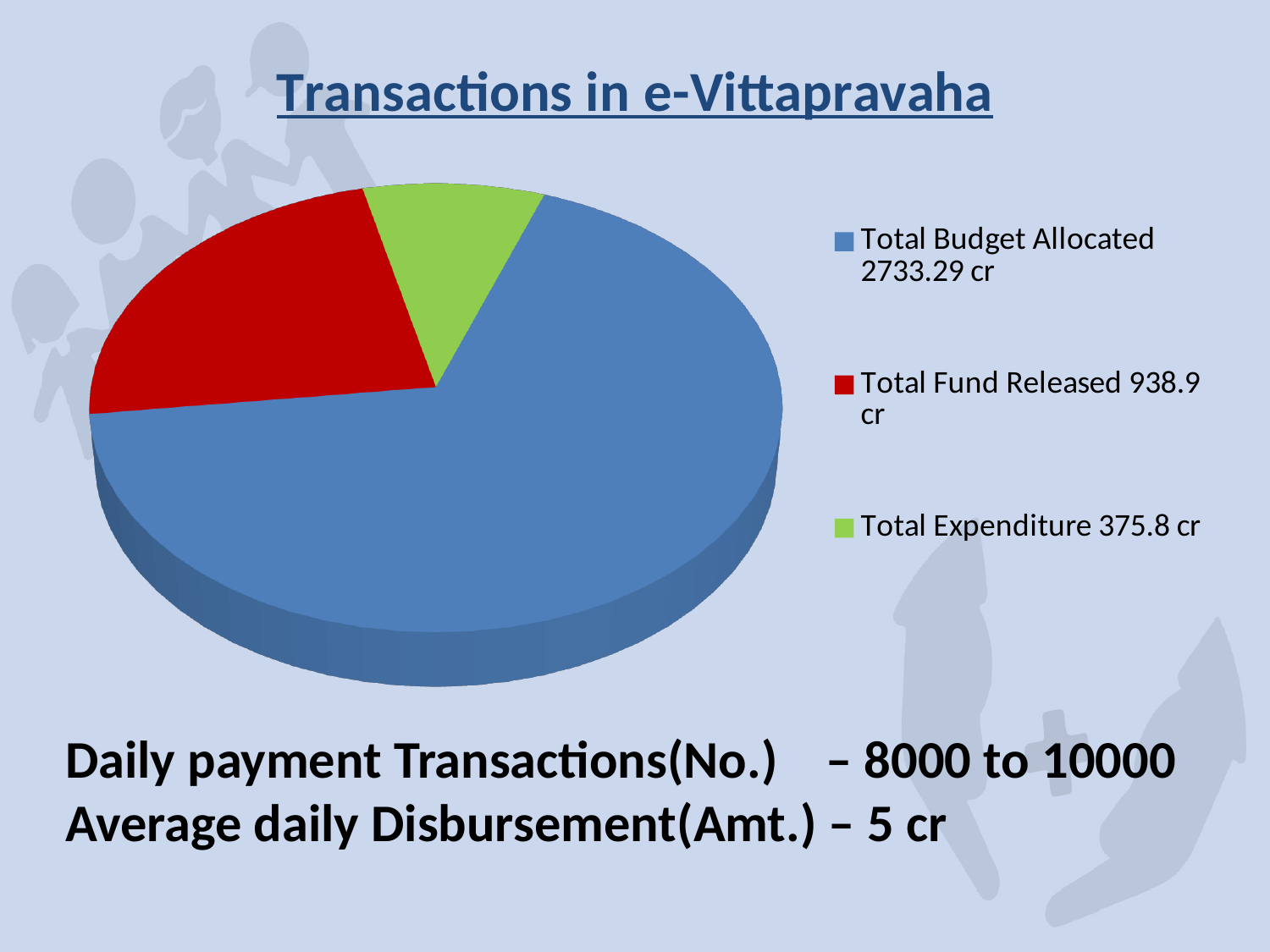
What is the title of the chart on the slide? Transactions in e-Vittapravaha What is the difference between Total Fund Released and Total Expenditure? 563.1 cr Which category has the largest slice of the pie? Total Budget Allocated Which category has the smallest slice of the pie? Total Expenditure What colour is the slice for Total Expenditure? Green What value is shown for Total Budget Allocated? 2733.29 cr What value is shown for Total Fund Released? 938.9 cr How many slices does the pie chart have? 3 What kind of chart is shown on the slide? Pie chart What is the difference between Total Budget Allocated and Total Fund Released? 1794.39 cr What value is shown for Total Expenditure? 375.8 cr Which is larger, Total Fund Released or Total Expenditure? Total Fund Released